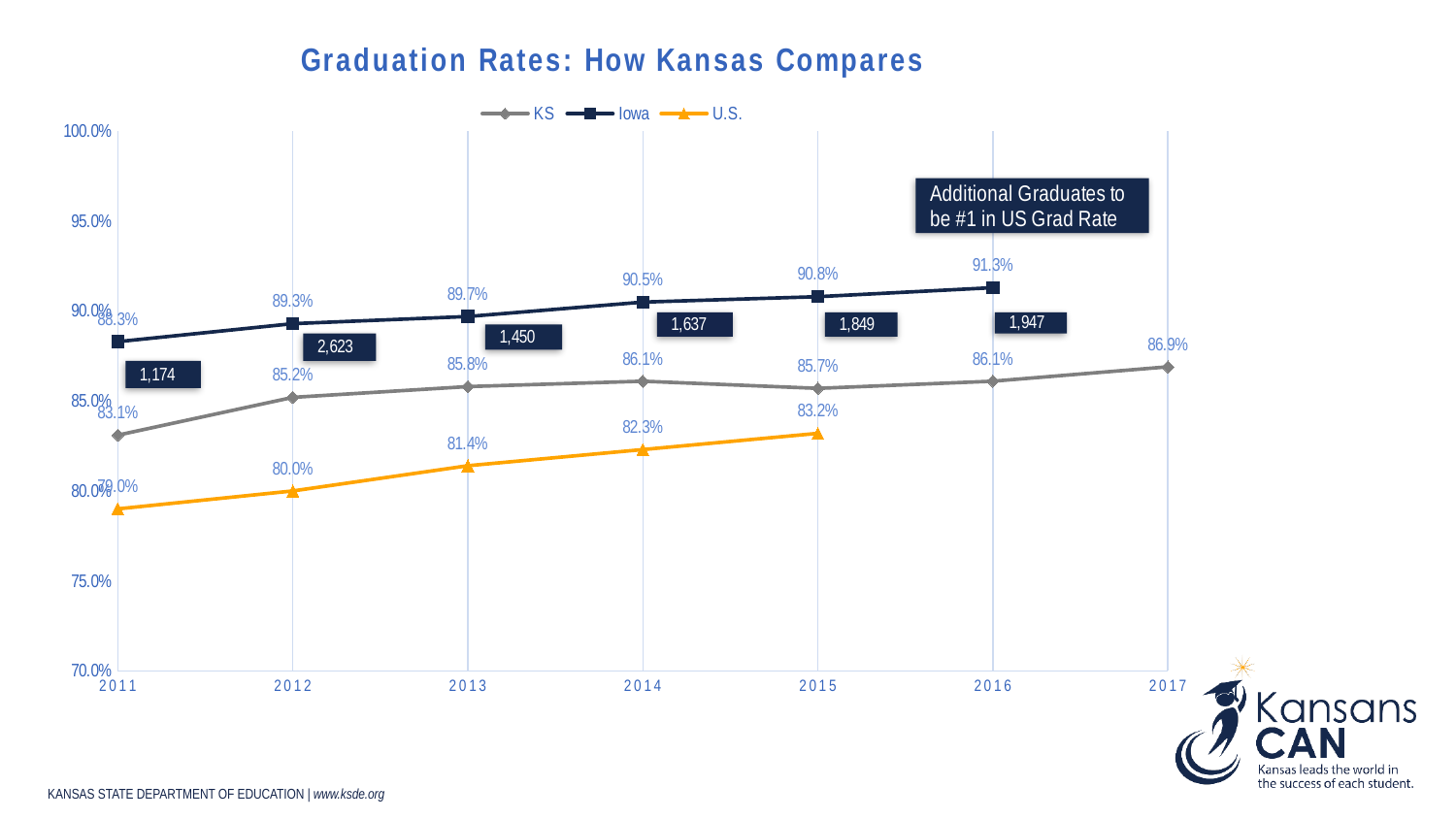
Does the U.S. graduation rate rise or fall from 2011 to 2015? Rise Which is higher in 2015, the KS graduation rate or the U.S. graduation rate? KS How many years are shown on the x axis? 7 How many additional graduates would Kansas have needed in 2012 to be #1 in US grad rate? 2,623 How many series does the legend list? 3 What is the difference between the Iowa and KS graduation rates in 2016? 5.2% What is the U.S. graduation rate in 2013? 81.4% In which year is the KS graduation rate lowest? 2011 What is the Iowa graduation rate in 2014? 90.5% What is the KS graduation rate in 2017? 86.9% What kind of chart is shown on the slide? Line chart In which year is the Iowa graduation rate highest? 2016